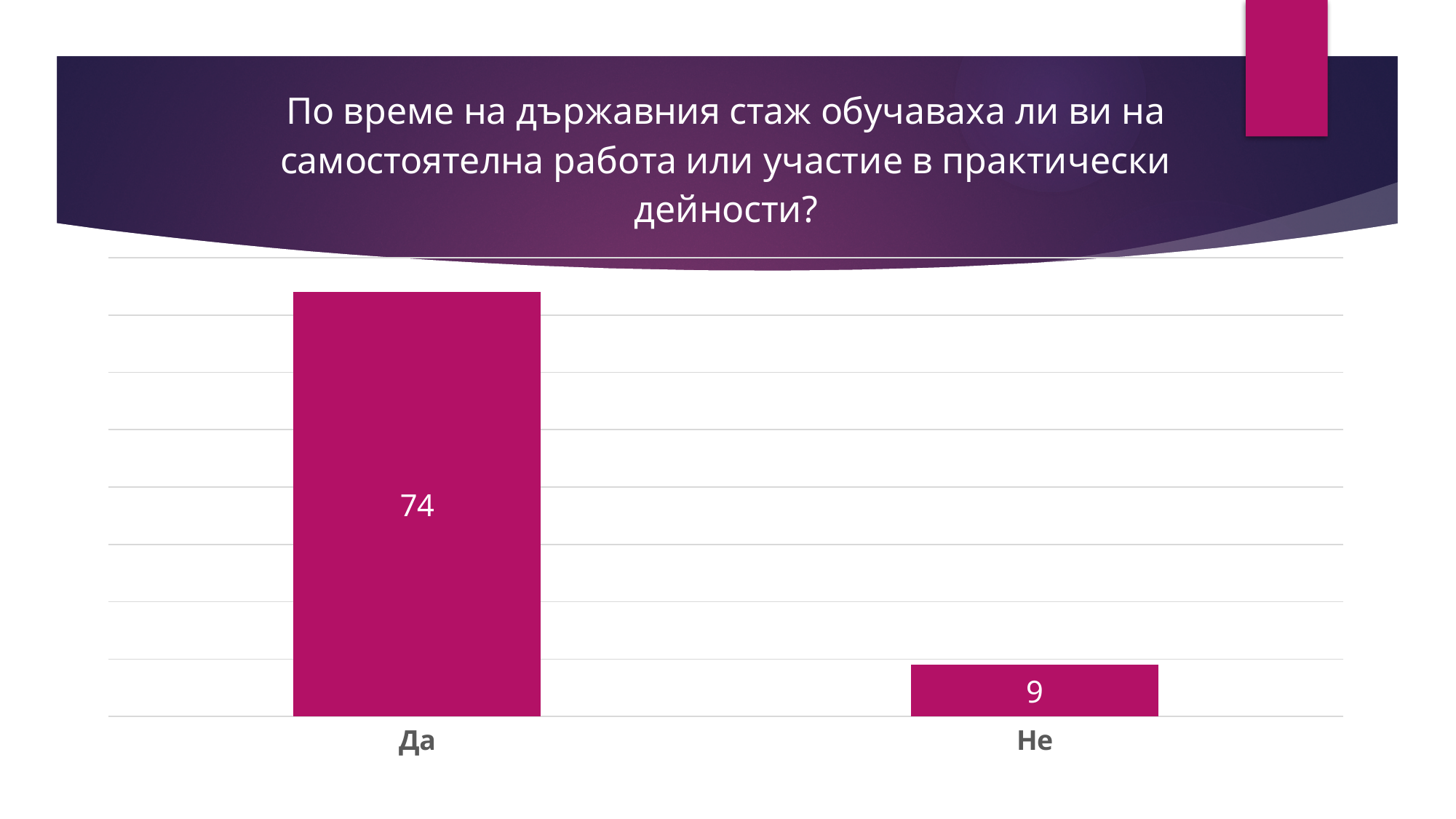
What is the title of the slide? По време на държавния стаж обучаваха ли ви на самостоятелна работа или участие в практически дейности? What kind of chart is shown on the slide? bar chart Which category has the highest value? Да What is the difference between the values for "Да" and "Не"? 65 Which category has the lowest value? Не What is the value for "Да"? 74 What colour are the bars in the chart? magenta What is the value for "Не"? 9 What is the total of the two values shown in the chart? 83 How many categories are shown in the chart? 2 Which is larger, the value for "Да" or the value for "Не"? Да